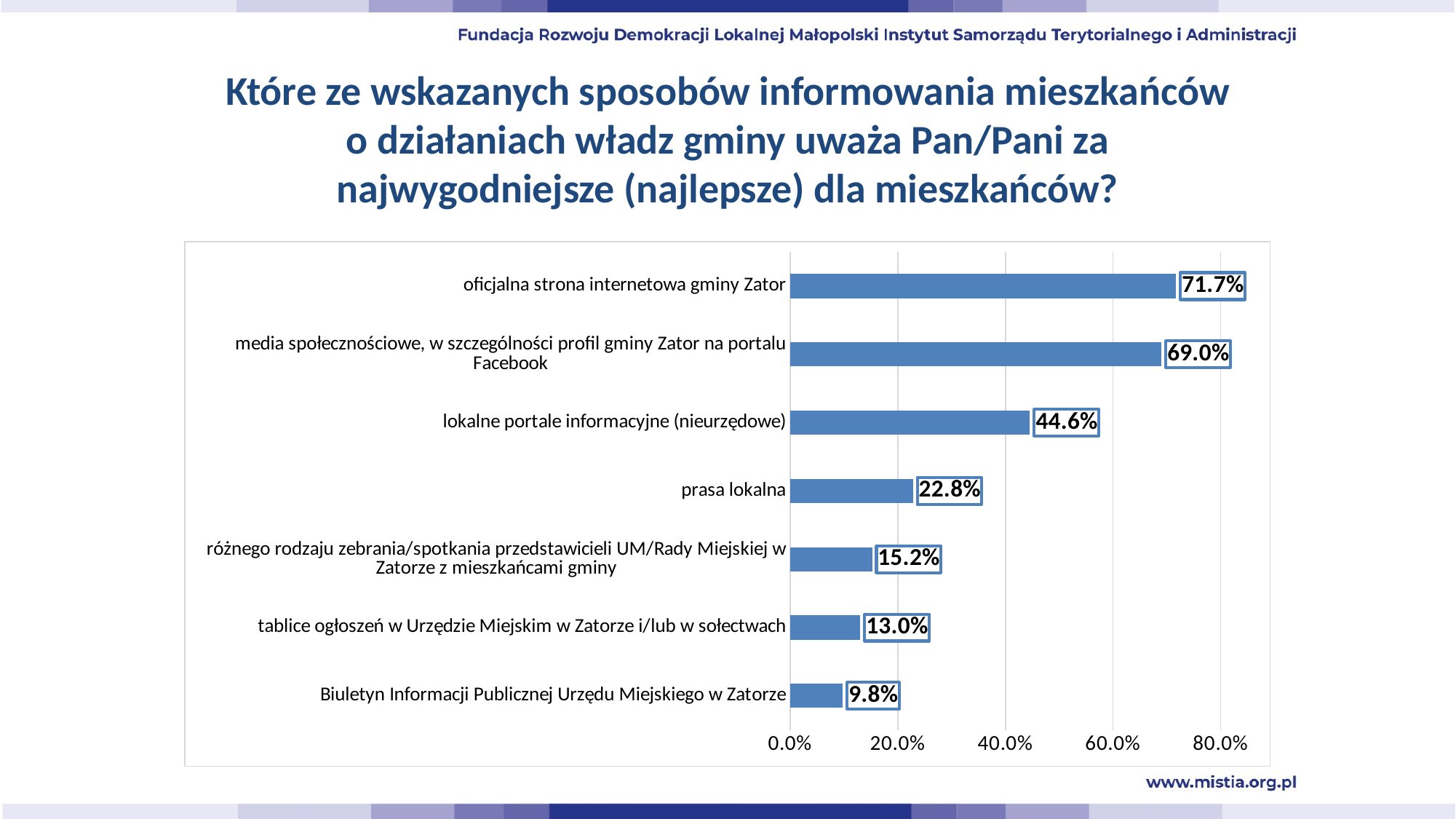
Which category has the lowest value? Biuletyn Informacji Publicznej Urzędu Miejskiego w Zatorze What is the value for "tablice ogłoszeń w Urzędzie Miejskim w Zatorze i/lub w sołectwach"? 13.0% What is the difference between the values for "oficjalna strona internetowa gminy Zator" and "media społecznościowe, w szczególności profil gminy Zator na portalu Facebook"? 2.7% How many categories are shown in the chart? 7 What kind of chart is shown on the slide? bar chart Which is larger: the value for "lokalne portale informacyjne (nieurzędowe)" or the value for "prasa lokalna"? lokalne portale informacyjne (nieurzędowe) What is the difference between the values for "prasa lokalna" and "Biuletyn Informacji Publicznej Urzędu Miejskiego w Zatorze"? 13.0% What is the value for "oficjalna strona internetowa gminy Zator"? 71.7% Which category has the highest value? oficjalna strona internetowa gminy Zator Is the value for "różnego rodzaju zebrania/spotkania przedstawicieli UM/Rady Miejskiej w Zatorze z mieszkańcami gminy" greater or less than 20.0%? less What is the value for "prasa lokalna"? 22.8% What is the value for "lokalne portale informacyjne (nieurzędowe)"? 44.6%